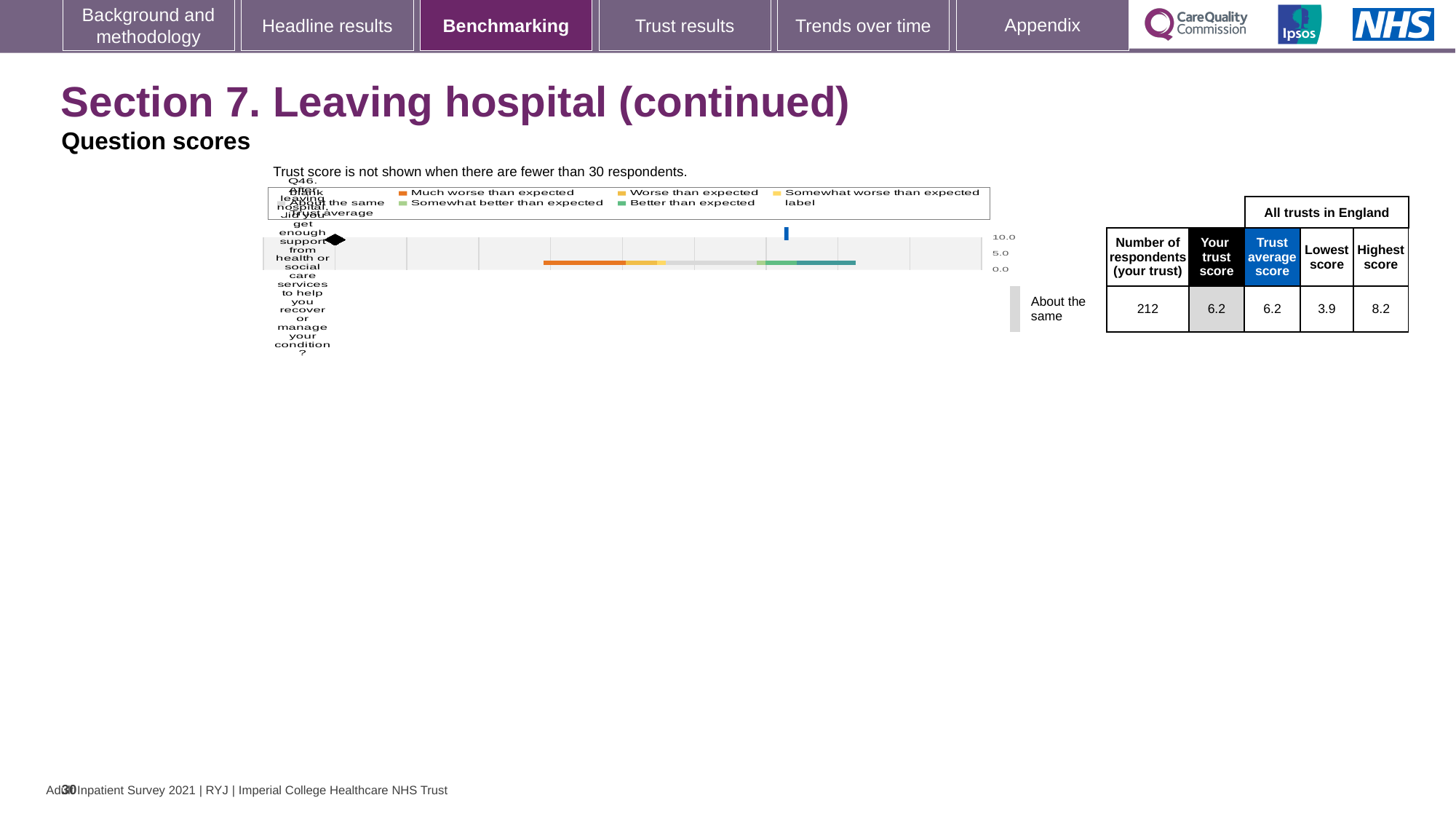
Which is larger for Q46, your trust score or the lowest score? your trust score What is your trust score for Q46? 6.2 What benchmark category is the trust's result for Q46 labelled as next to the chart? About the same What is the highest value shown on the chart's numeric axis? 10.0 Which legend entry is shown in orange on the chart? Much worse than expected What kind of chart is shown on the slide? bar chart What is the lowest score among all trusts in England for Q46? 3.9 What is the difference between the highest score and the lowest score for Q46? 4.3 What is the trust average score for Q46? 6.2 What is the highest score among all trusts in England for Q46? 8.2 What is the number of respondents for your trust shown for Q46? 212 Is your trust score for Q46 greater or less than 5.0? greater